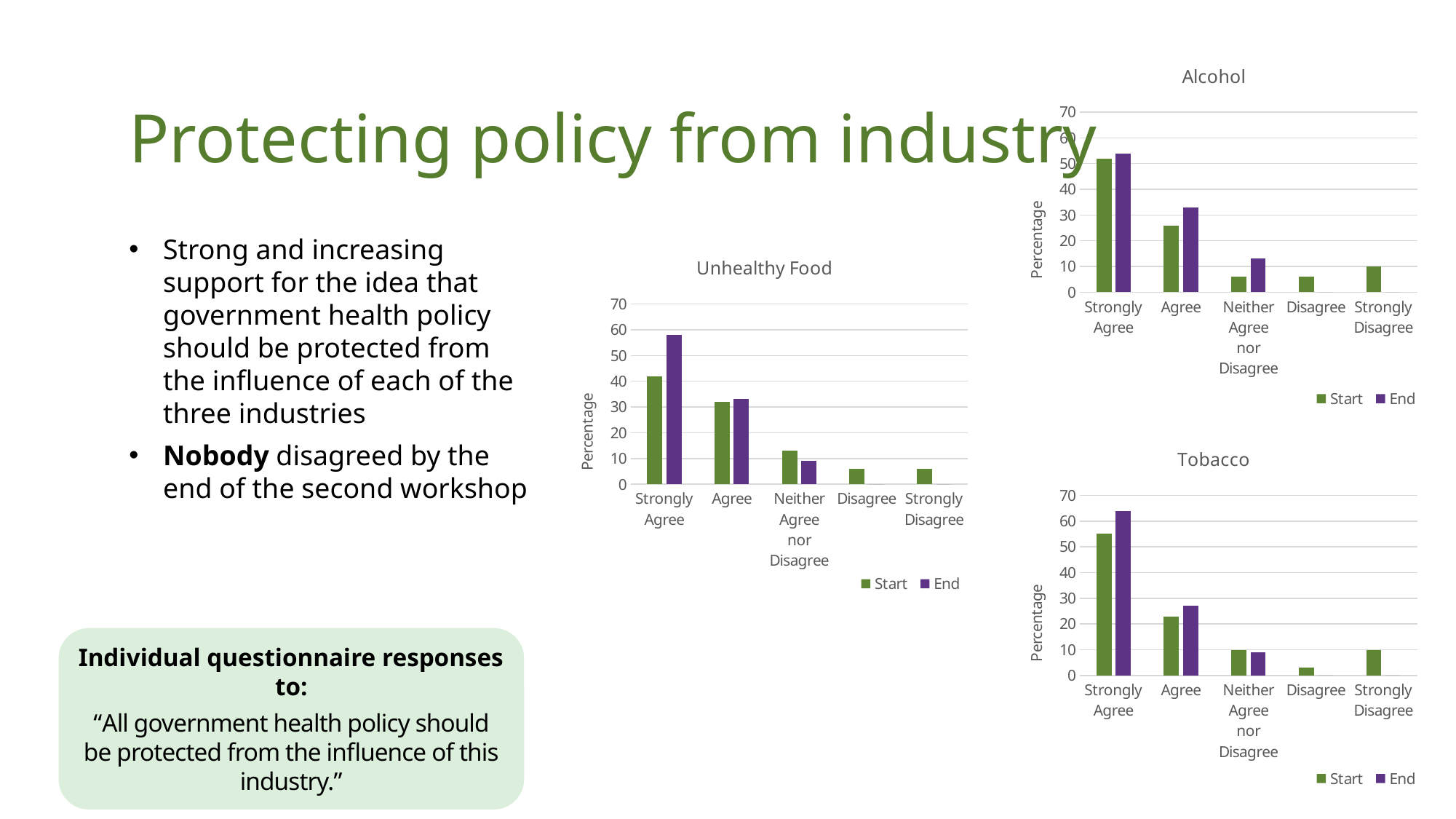
How many response categories are shown on the x axis of the Unhealthy Food chart? 5 In the Tobacco chart, is the End value for Strongly Agree greater or less than 60? greater In the Alcohol chart, which category has the highest Start value? Strongly Agree What kind of chart is the Unhealthy Food chart? Bar chart In the Unhealthy Food chart, is the End value for Strongly Agree greater or less than 50? greater In the Alcohol chart, is the Start value for Agree greater or less than 30? less In the Alcohol chart, which is larger for Neither Agree nor Disagree, the Start value or the End value? End How many series does the legend of the Alcohol chart list? 2 What is the y-axis label on the Tobacco chart? Percentage In the Unhealthy Food chart, which is larger for Strongly Agree, the Start value or the End value? End In the Tobacco chart, which category has the highest End value? Strongly Agree